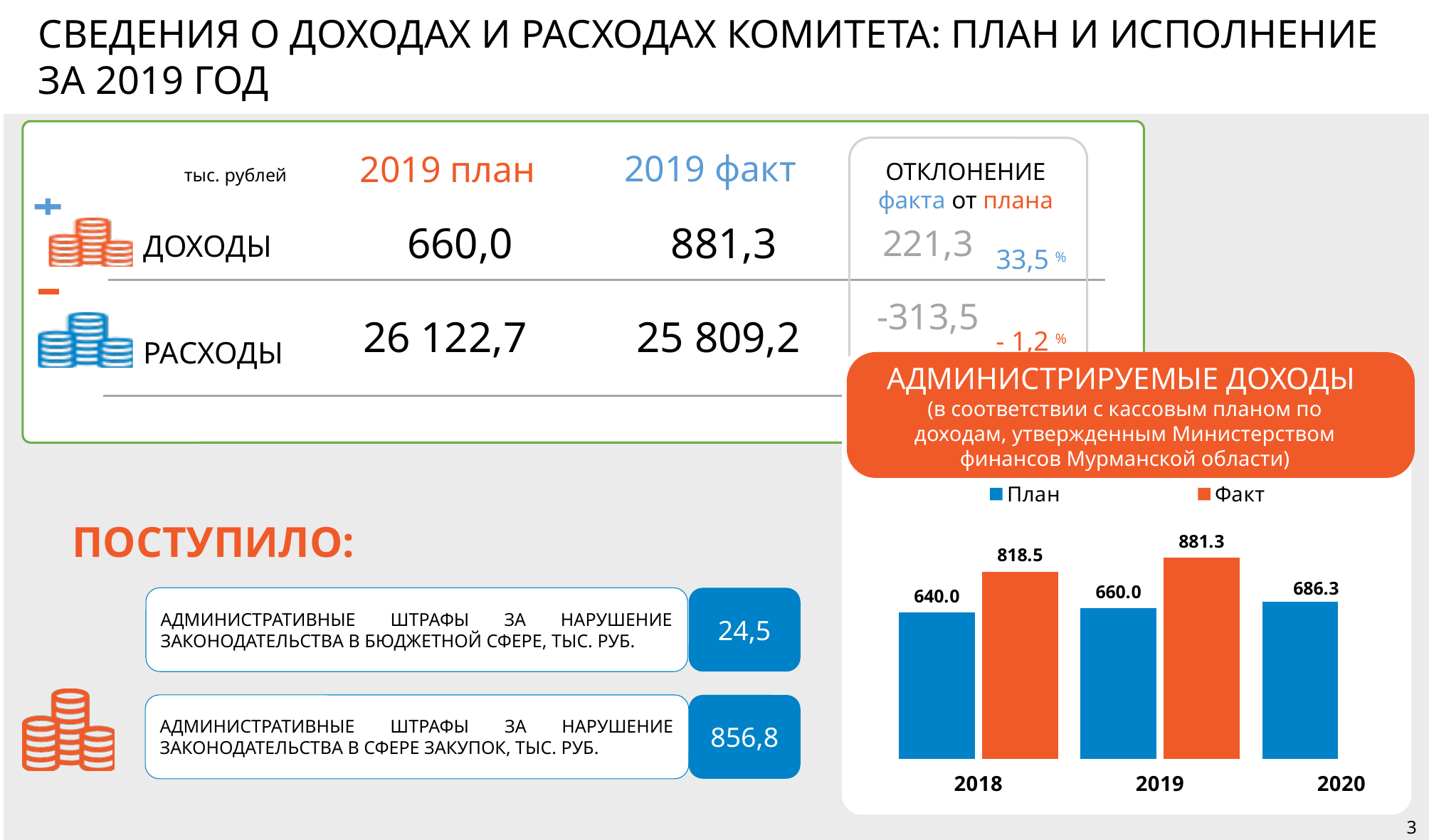
Which is larger in 2018: the План value or the Факт value? Факт Which year has the highest Факт value in the chart? 2019 What is the План value for 2020 in the chart? 686.3 What is the difference between the Факт and План values for 2019? 221.3 What type of chart is shown on the slide? Bar chart How many series does the chart legend list? 2 What is the Факт value for 2019 in the chart? 881.3 What is the difference between the План values for 2020 and 2018? 46.3 Which year has the lowest План value in the chart? 2018 What is the План value for 2019 in the chart? 660.0 Does the План series rise or fall from 2018 to 2020? Rises What is the Факт value for 2018 in the chart? 818.5